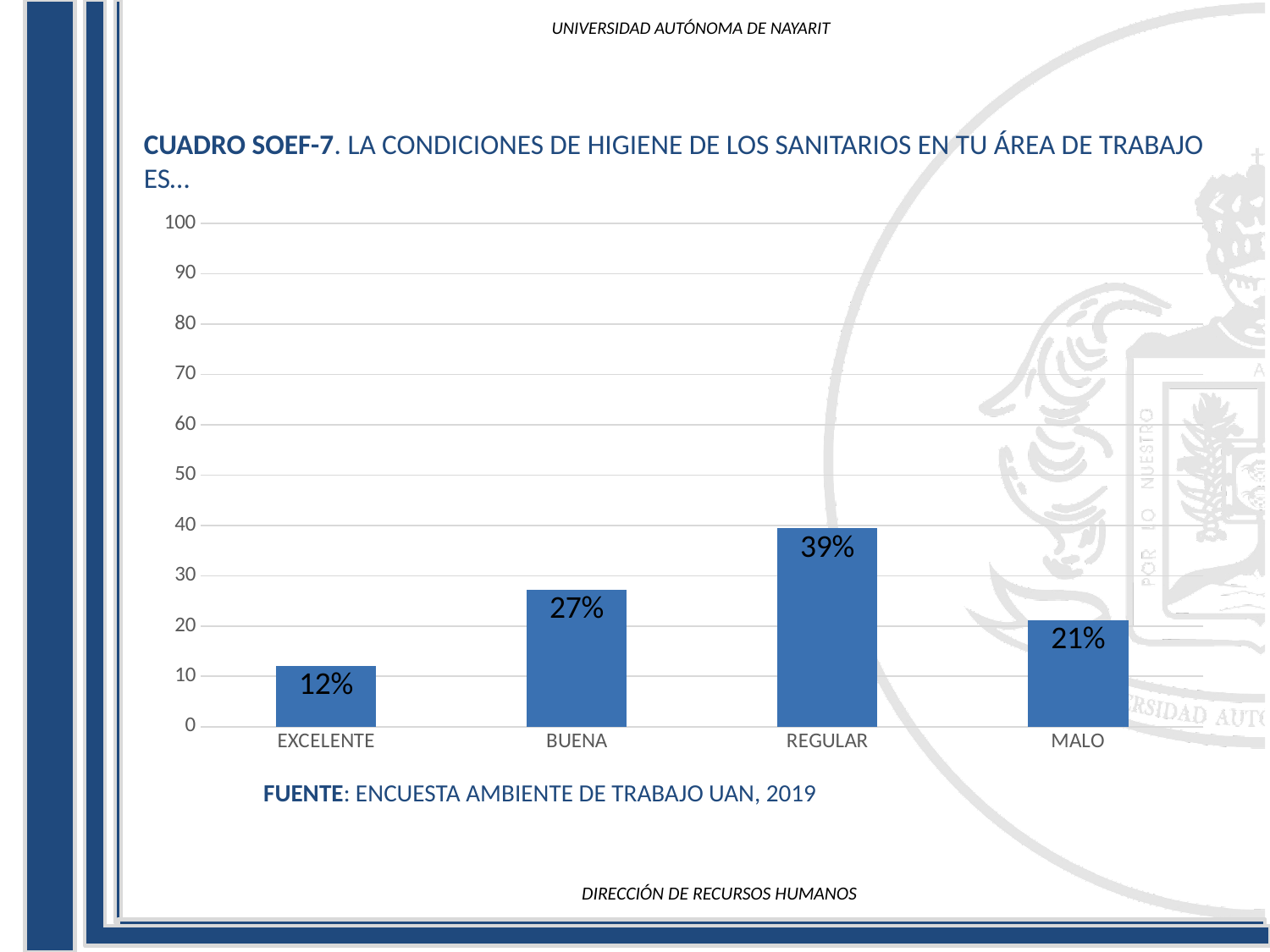
Which is larger, the value for BUENA or the value for MALO? BUENA What is the value for REGULAR? 39% What is the difference between the values for REGULAR and BUENA? 12% What kind of chart is shown on the slide? bar chart Which category has the highest value? REGULAR What is the value for MALO? 21% Is the value for MALO greater or less than 30? less What source is cited below the chart? ENCUESTA AMBIENTE DE TRABAJO UAN, 2019 What is the value for EXCELENTE? 12% What is the value for BUENA? 27% How many categories are shown on the x axis? 4 Which category has the lowest value? EXCELENTE